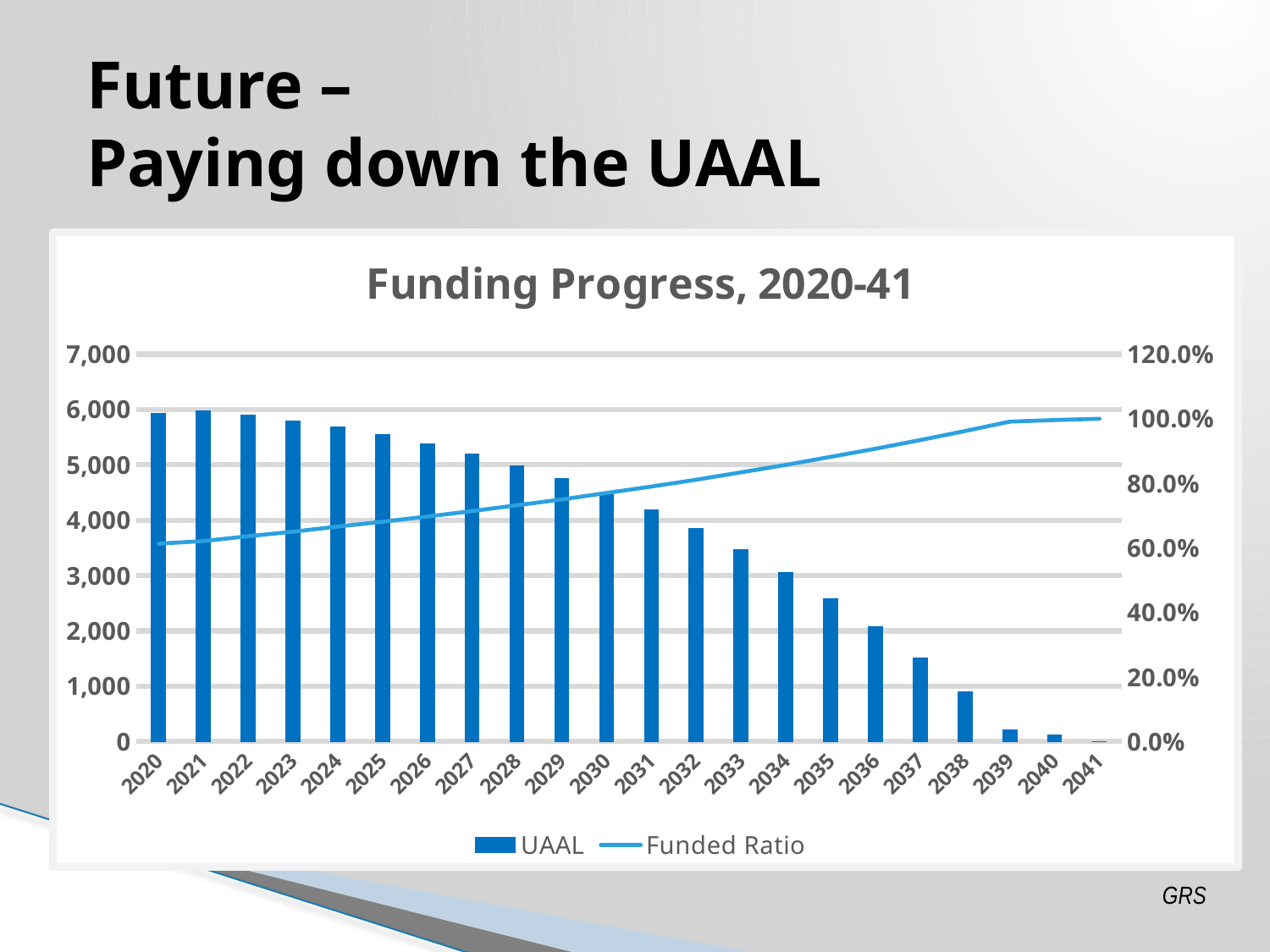
Is the UAAL value for 2038 greater or less than 1,000? less Is the Funded Ratio for 2039 greater or less than 80.0%? greater How many series does the legend list? 2 What is the title of the chart? Funding Progress, 2020-41 Is the UAAL value for 2035 greater or less than 2,000? greater Which year has the lowest UAAL value? 2041 Which is larger, the UAAL value for 2025 or for 2035? 2025 What kind of chart is this? A combination bar and line chart How many years are shown on the x axis? 22 What are the names of the two series in the legend? UAAL and Funded Ratio